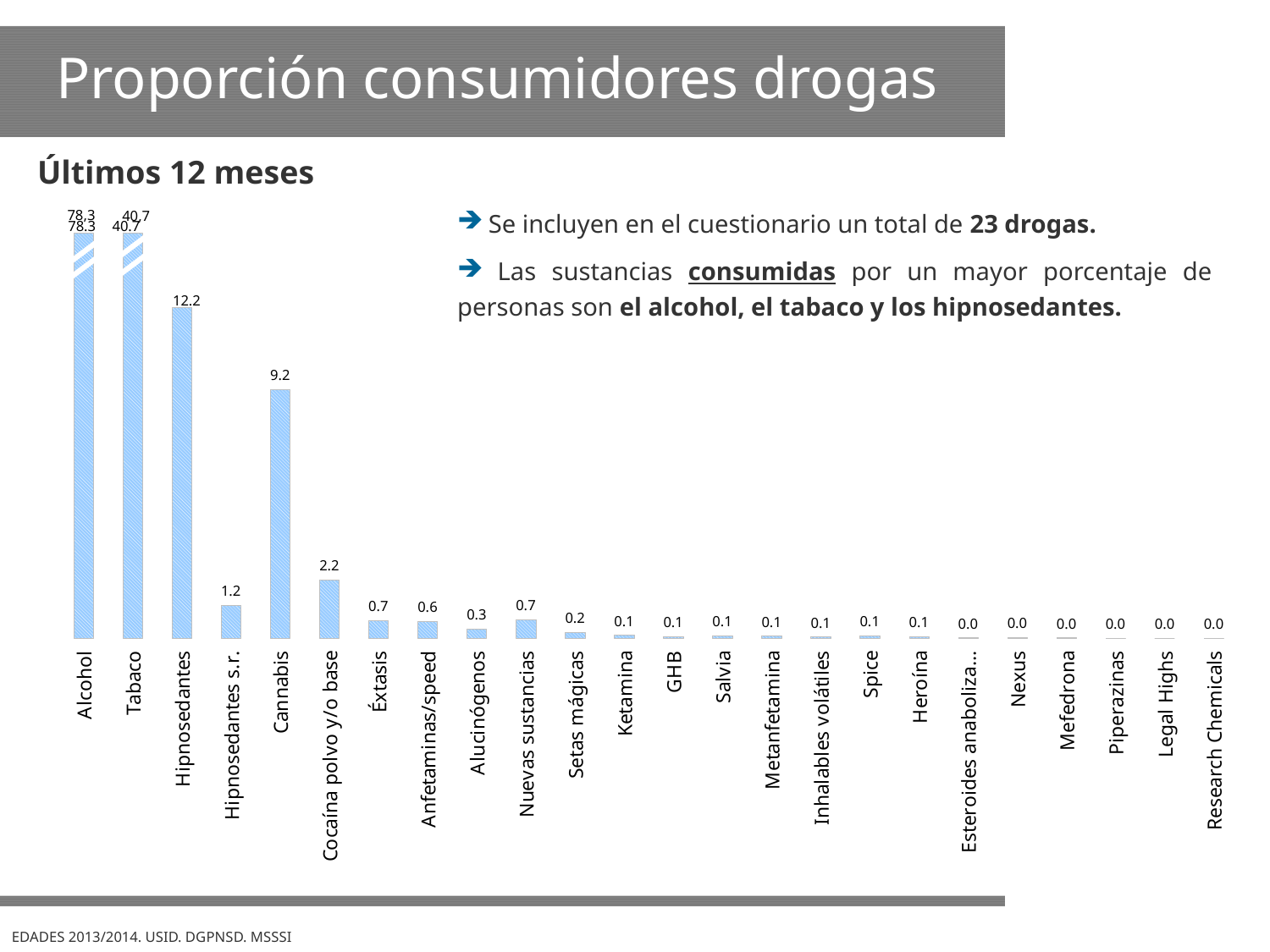
What is the value for Alcohol? 78.3 Which is larger, the value for Cocaína polvo y/o base or the value for Hipnosedantes s.r.? Cocaína polvo y/o base What kind of chart is shown on the slide? Bar chart What is the value for Heroína? 0.1 What is the value for Hipnosedantes? 12.2 What is the difference between the values for Alcohol and Tabaco? 37.6 What is the value for Tabaco? 40.7 What is the difference between the values for Hipnosedantes and Cannabis? 3.0 Which category has the highest value? Alcohol What is the value for Cocaína polvo y/o base? 2.2 What is the subtitle shown above the chart? Últimos 12 meses What is the value for Cannabis? 9.2